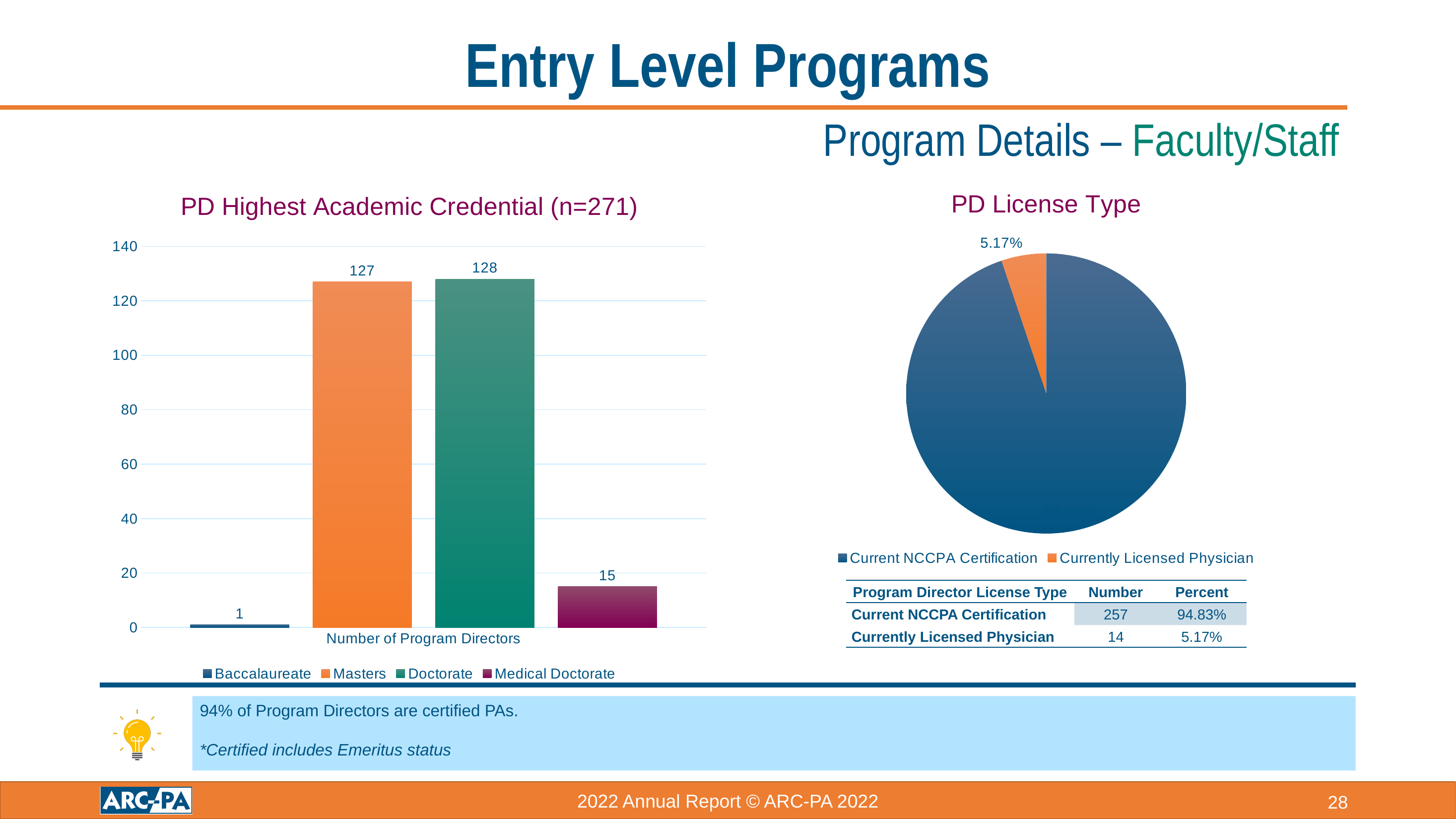
In the PD Highest Academic Credential chart, what is the value for Medical Doctorate? 15 In the PD Highest Academic Credential chart, which credential has the highest number of program directors? Doctorate In the PD Highest Academic Credential chart, what is the value for Baccalaureate? 1 In the PD Highest Academic Credential chart, how many program directors hold a Masters as their highest credential? 127 In the PD License Type chart, what percent of program directors have Current NCCPA Certification? 94.83% In the PD Highest Academic Credential chart, which credential has the lowest number of program directors? Baccalaureate In the PD Highest Academic Credential chart, how many credential categories does the legend list? 4 In the PD License Type chart, which license type has the larger share: Current NCCPA Certification or Currently Licensed Physician? Current NCCPA Certification In the PD Highest Academic Credential chart, what is the value for Doctorate? 128 In the PD License Type pie chart, what share of program directors are Currently Licensed Physicians? 5.17% In the PD Highest Academic Credential chart, what is the difference between the Doctorate and Medical Doctorate values? 113 What type of chart is the PD Highest Academic Credential chart? Bar chart